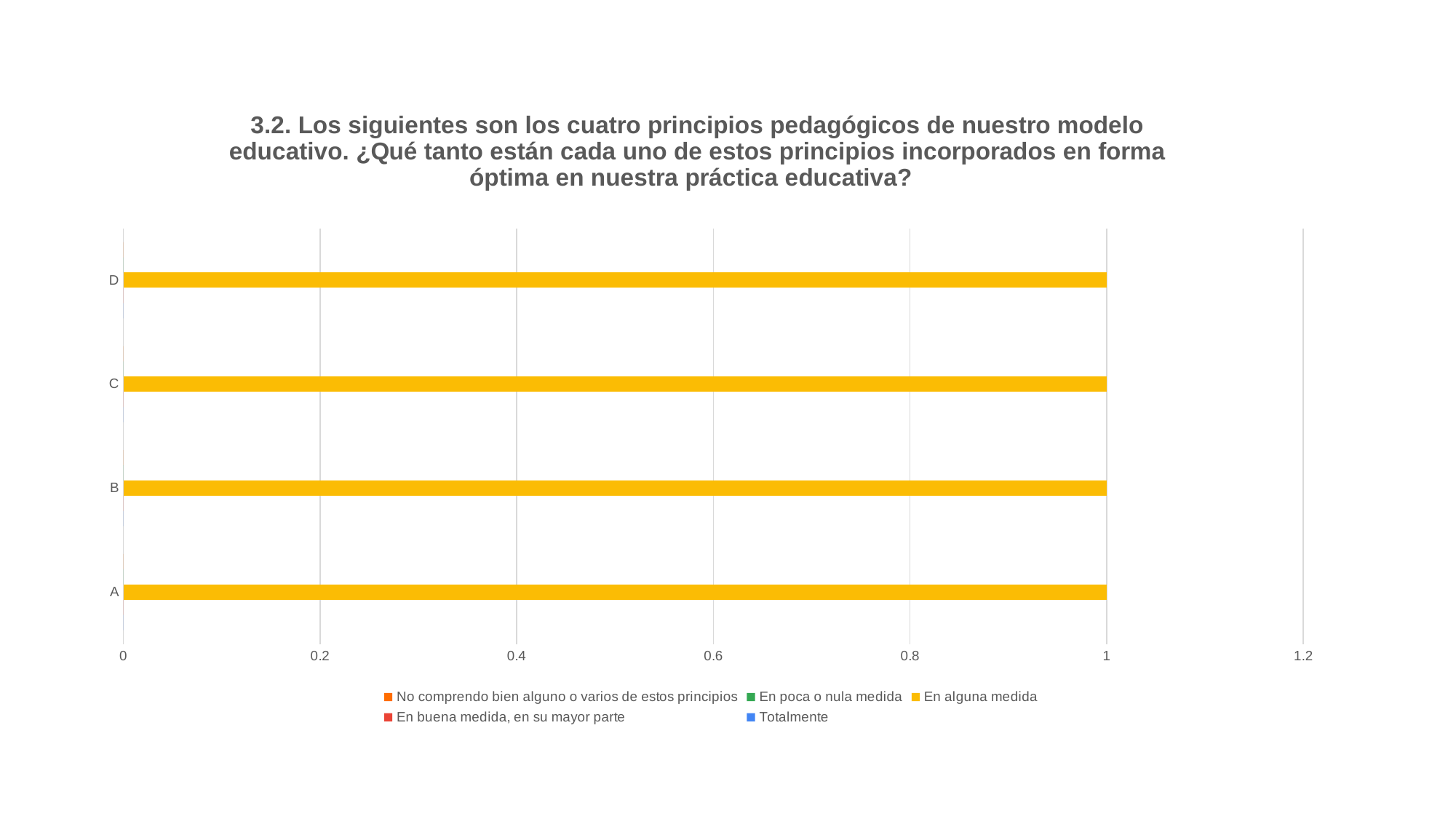
What is the value of the 'En alguna medida' bar for category A? 1 How many series does the chart's legend list? 5 What kind of chart is shown on the slide? bar chart Is the value for category B greater or less than 0.8? greater How many categories are shown on the vertical axis of the chart? 4 What is the highest value shown on the horizontal axis of the chart? 1.2 What colour are the bars plotted in the chart? yellow Which series do the visible bars in the chart belong to? En alguna medida Is the value for category C greater or less than 1.2? less What is the difference between the values for category A and category D? 0 What is the value of the 'En alguna medida' bar for category D? 1